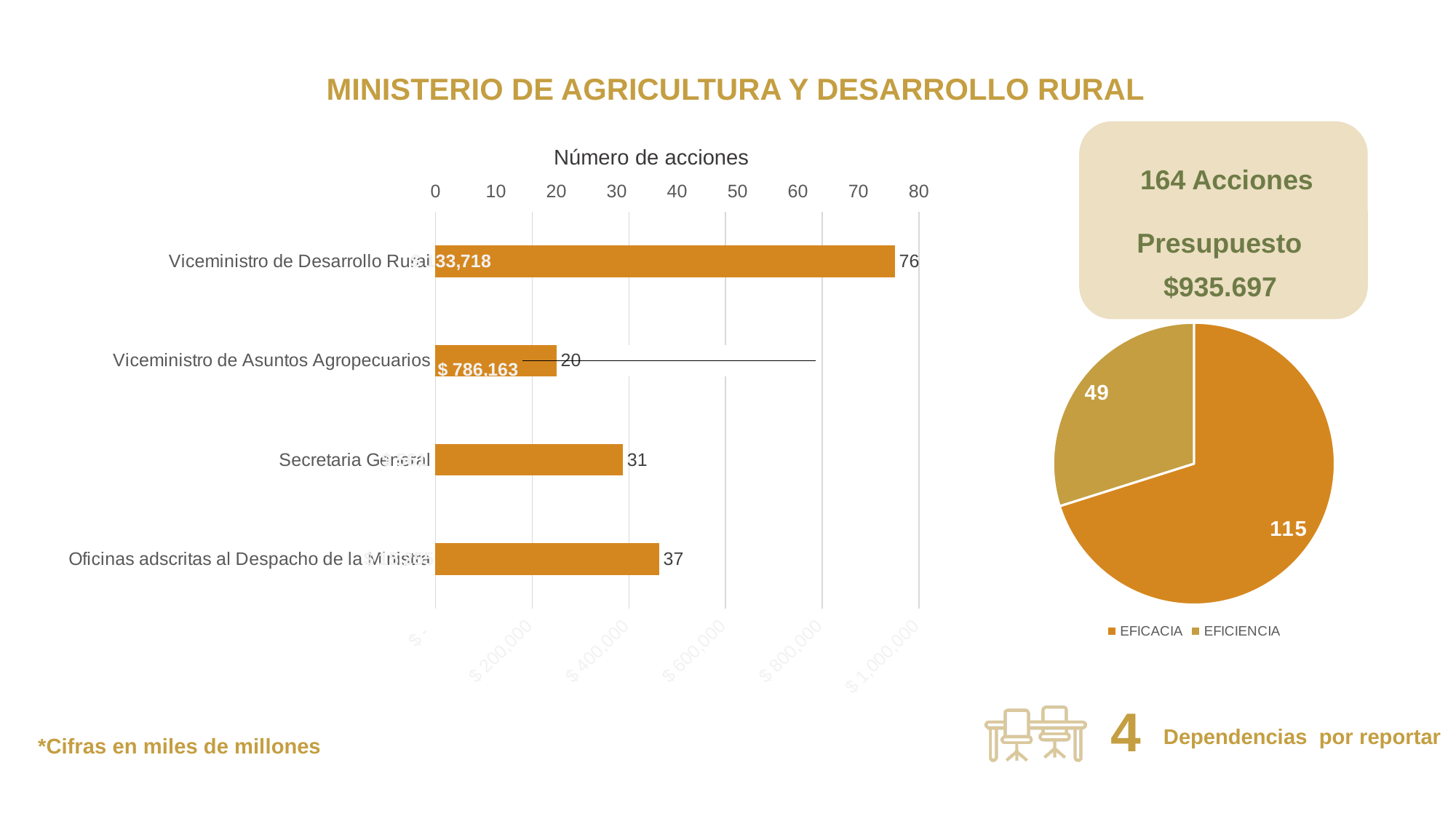
How many categories are shown in the bar chart 'Número de acciones'? 4 How many series does the legend of the pie chart on the right list? 2 In the bar chart 'Número de acciones', which category has the highest number of actions? Viceministro de Desarrollo Rural In the bar chart 'Número de acciones', what is the difference between the actions for Viceministro de Desarrollo Rural and Viceministro de Asuntos Agropecuarios? 56 What kind of chart is the chart titled 'Número de acciones'? Bar chart In the bar chart 'Número de acciones', how many actions are shown for Viceministro de Desarrollo Rural? 76 In the bar chart 'Número de acciones', how many actions are shown for Secretaria General? 31 In the bar chart 'Número de acciones', which category has the lowest number of actions? Viceministro de Asuntos Agropecuarios In the pie chart on the right, what is the value for EFICACIA? 115 In the bar chart 'Número de acciones', how many actions are shown for Oficinas adscritas al Despacho de la Ministra? 37 In the bar chart 'Número de acciones', which has more actions: Secretaria General or Oficinas adscritas al Despacho de la Ministra? Oficinas adscritas al Despacho de la Ministra In the pie chart on the right, what is the value for EFICIENCIA? 49